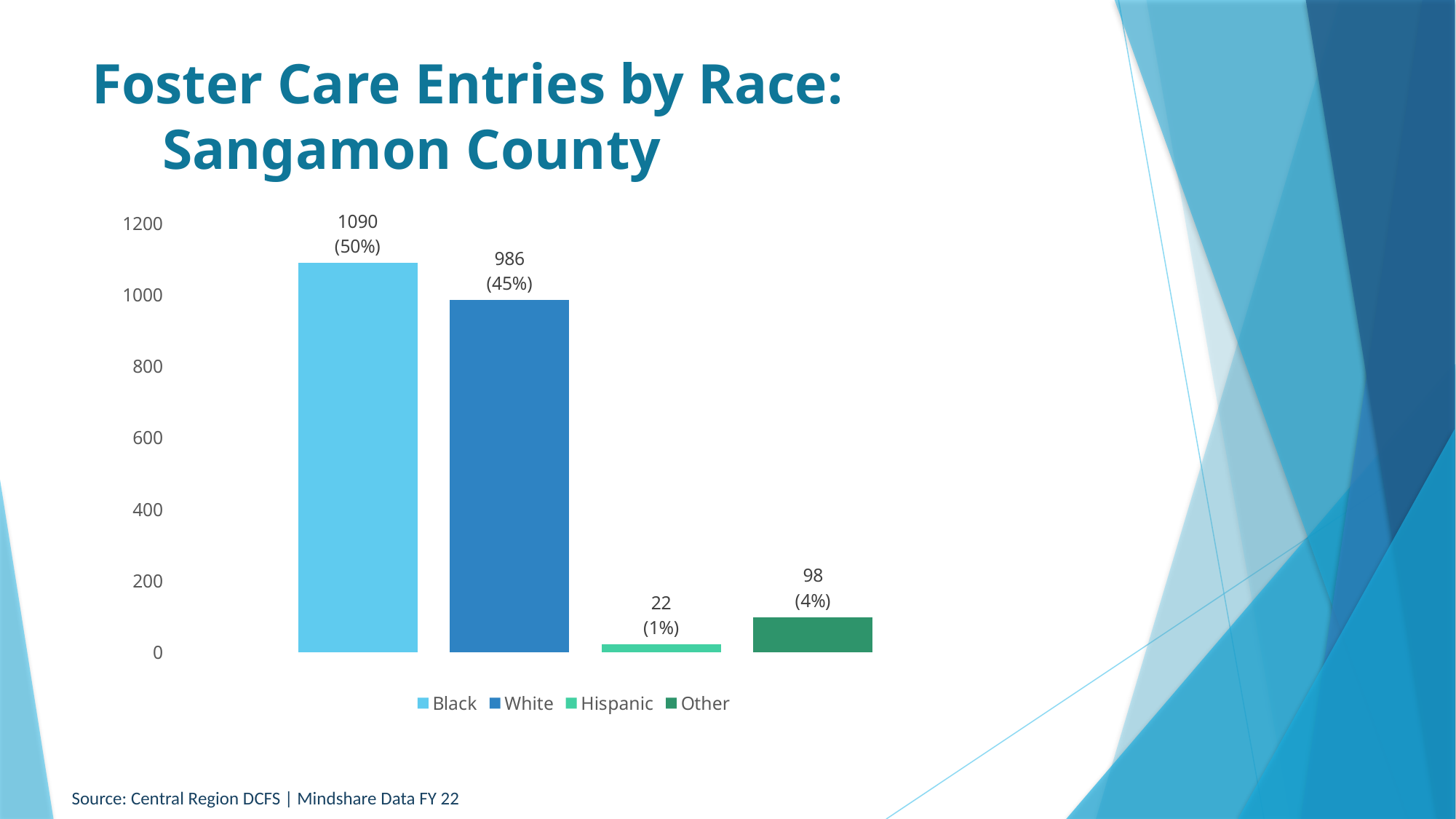
Which race category has the lowest number of foster care entries? Hispanic How many race categories are plotted in the chart? 4 What value is shown for the Other category? 98 How many foster care entries are shown for Black children in Sangamon County? 1090 What kind of chart is shown on the slide? Bar chart How many foster care entries are shown for Hispanic children? 22 What percentage of foster care entries in Sangamon County is shown for White children? 45% What is the source cited for the chart data? Central Region DCFS | Mindshare Data FY 22 Is the value for White greater or less than 800? greater Which has more foster care entries, Other or Hispanic? Other Which race category has the highest number of foster care entries? Black What is the difference between the number of entries for Black and White children? 104